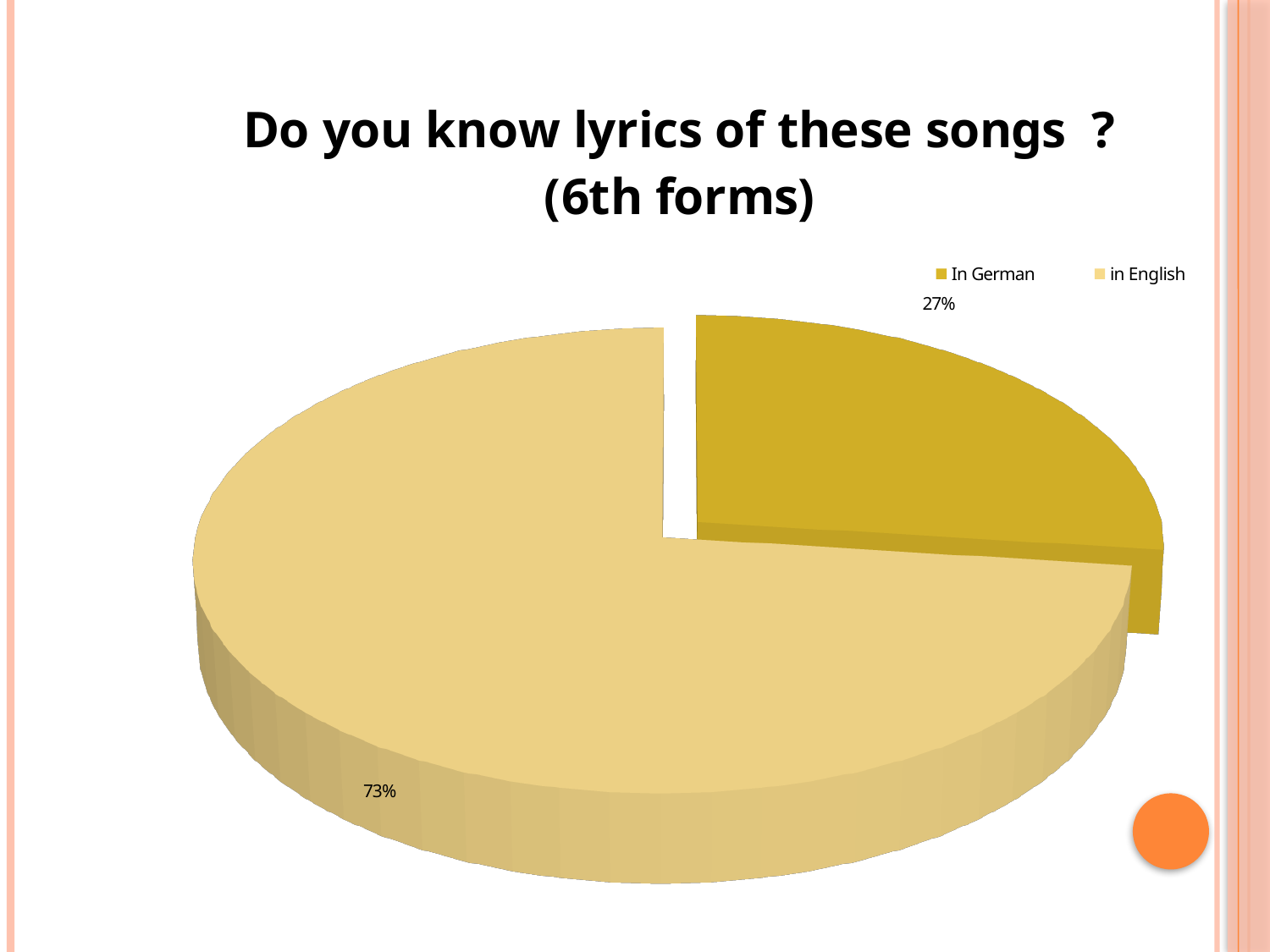
What share of the pie is labelled "In German"? 27% How many entries does the legend list? 2 Which is larger, the "In German" slice or the "in English" slice? in English What kind of chart is shown on the slide? pie chart How many slices does the pie chart have? 2 Which slice is the largest? in English What is the difference in percentage points between the "in English" and "In German" slices? 46 What is the title of the chart? Do you know lyrics of these songs ? (6th forms) Which slice is the smallest? In German What share of the pie is labelled "in English"? 73% Which legend entry is shown in the darker gold colour? In German